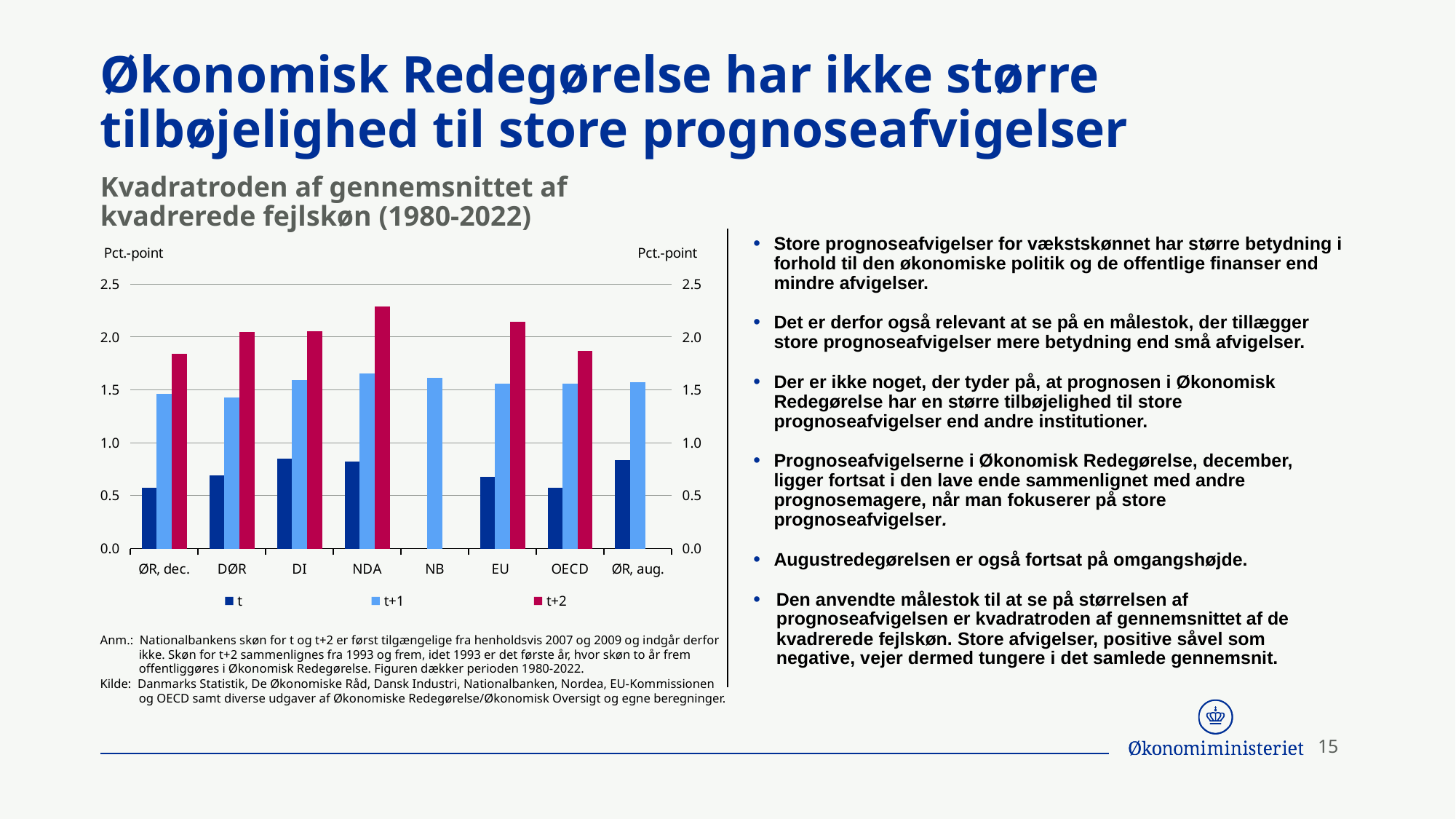
Which is larger, the t+2 value for NDA or the t+2 value for EU? NDA How many categories are shown on the x axis? 8 Which is larger, the t value for DI or the t value for ØR, dec.? DI How many series does the legend list? 3 Is the t+2 value for ØR, dec. greater or less than 2.0? less Is the t+1 value for DI greater or less than 1.5? greater Which category has the highest t+2 value? NDA Is the t+1 value for DØR greater or less than 1.5? less Which category shows only a t+1 bar and no t or t+2 bars? NB What kind of chart is shown on the slide? bar chart